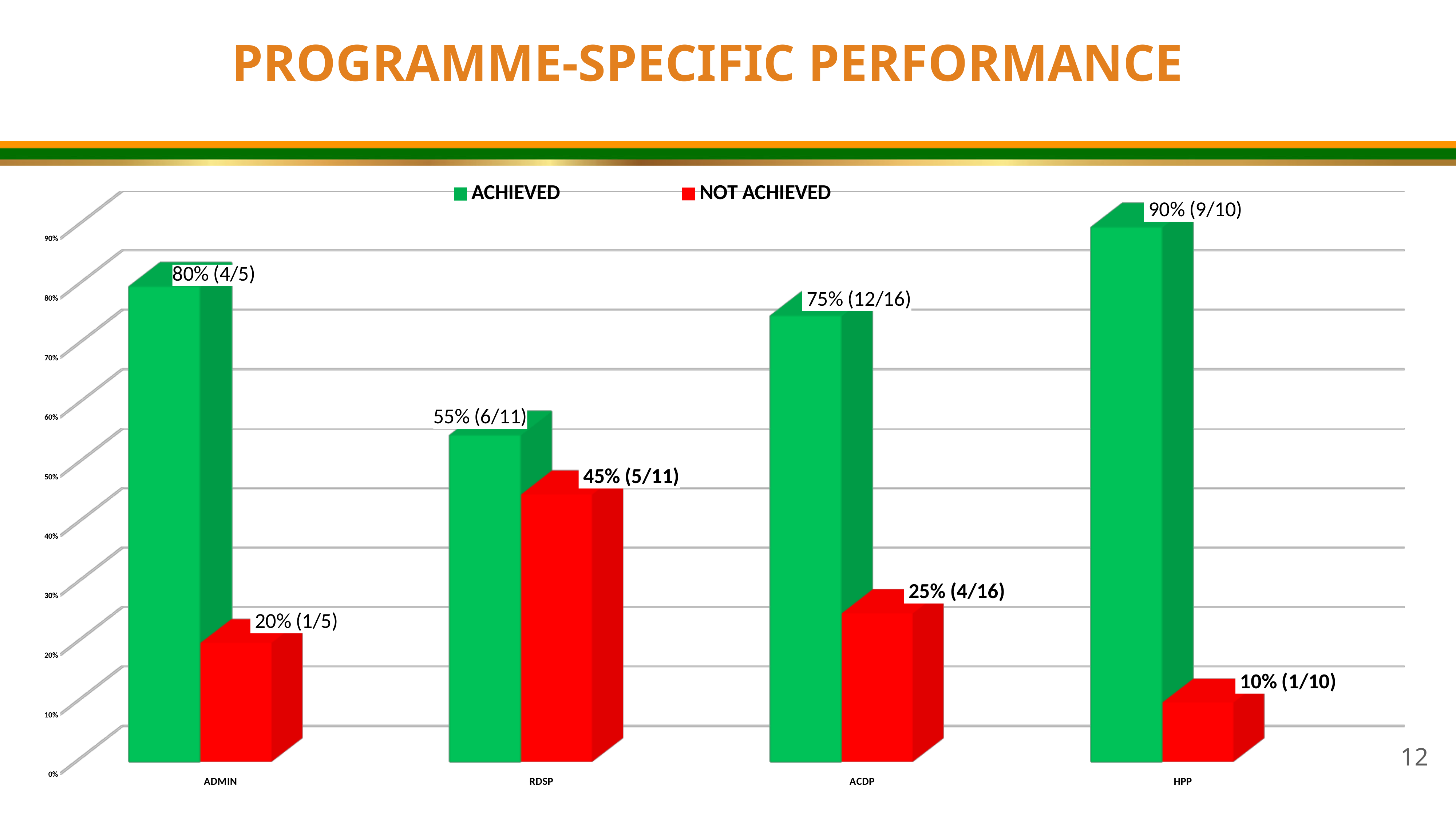
How many series does the legend list? 2 How many programmes are shown on the x axis? 4 What is the NOT ACHIEVED value for ACDP? 25% (4/16) What kind of chart is shown on the slide? Bar chart What is the ACHIEVED value for HPP? 90% (9/10) What is the ACHIEVED value for ADMIN? 80% (4/5) What is the NOT ACHIEVED value for RDSP? 45% (5/11) Which programme has the highest NOT ACHIEVED percentage? RDSP Which programme has the lowest ACHIEVED percentage? RDSP What is the difference in percentage points between the ACHIEVED values for HPP and ACDP? 15% Which programme has the highest ACHIEVED percentage? HPP Which is larger, the ACHIEVED value for ADMIN or the ACHIEVED value for ACDP? ADMIN